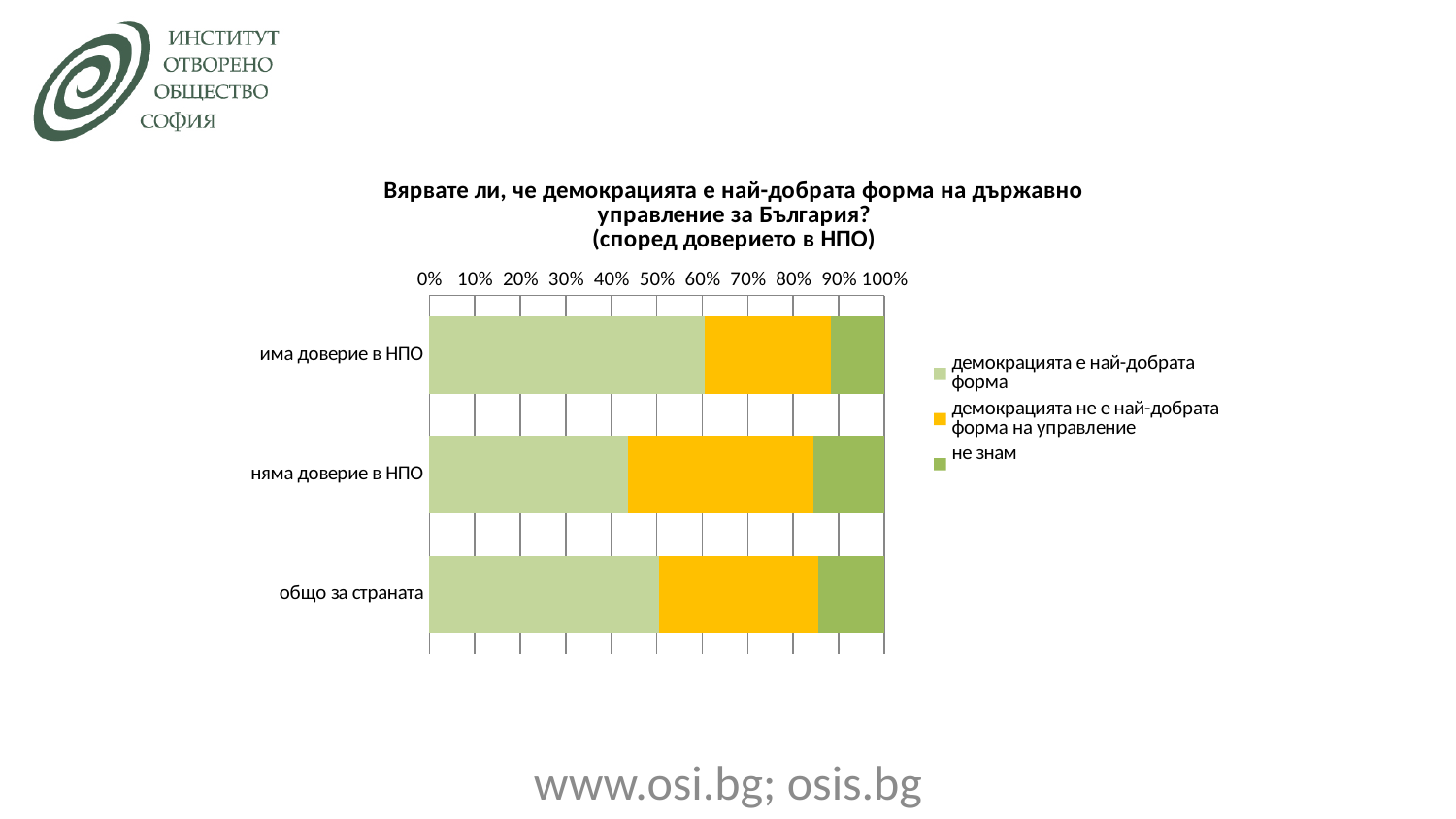
What kind of chart is shown on the slide? bar chart How many categories are shown on the vertical axis of the chart? 3 What is the third legend entry of the chart? не знам Is the value of "демокрацията не е най-добрата форма на управление" for "има доверие в НПО" greater or less than 40%? less Is the value of "демокрацията е най-добрата форма" for "има доверие в НПО" greater or less than 50%? greater Which category has the smallest share for "демокрацията е най-добрата форма"? няма доверие в НПО Is the value of "демокрацията е най-добрата форма" for "няма доверие в НПО" greater or less than 50%? less How many series does the chart's legend list? 3 Which category has a larger share for "демокрацията е най-добрата форма": "има доверие в НПО" or "общо за страната"? има доверие в НПО Which category has a larger share for "демокрацията не е най-добрата форма на управление": "има доверие в НПО" or "няма доверие в НПО"? няма доверие в НПО Which category has the largest share for "демокрацията е най-добрата форма"? има доверие в НПО What colour represents "демокрацията не е най-добрата форма на управление" in the chart? yellow